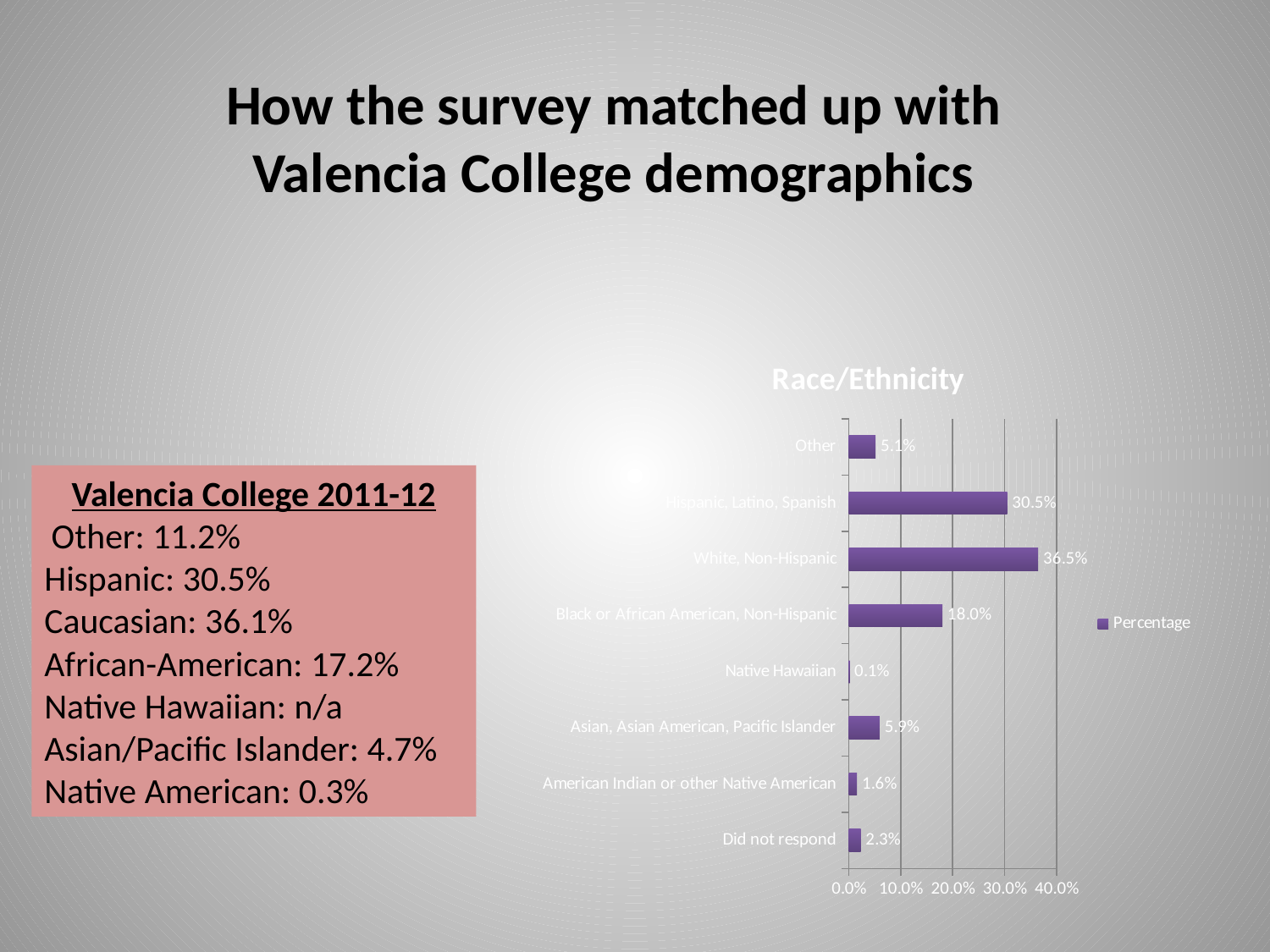
What is the value for Hispanic, Latino, Spanish in the Race/Ethnicity chart? 30.5% Which is larger in the Race/Ethnicity chart: Asian, Asian American, Pacific Islander or Other? Asian, Asian American, Pacific Islander What is the value for Did not respond in the Race/Ethnicity chart? 2.3% What is the difference between the values for White, Non-Hispanic and Hispanic, Latino, Spanish in the Race/Ethnicity chart? 6.0% What series name does the legend of the Race/Ethnicity chart show? Percentage What is the value for White, Non-Hispanic in the Race/Ethnicity chart? 36.5% Which category has the lowest value in the Race/Ethnicity chart? Native Hawaiian How many categories are shown in the Race/Ethnicity chart? 8 What is the value for Native Hawaiian in the Race/Ethnicity chart? 0.1% What kind of chart is the Race/Ethnicity chart? Bar chart Which category has the highest value in the Race/Ethnicity chart? White, Non-Hispanic What is the value for Black or African American, Non-Hispanic in the Race/Ethnicity chart? 18.0%